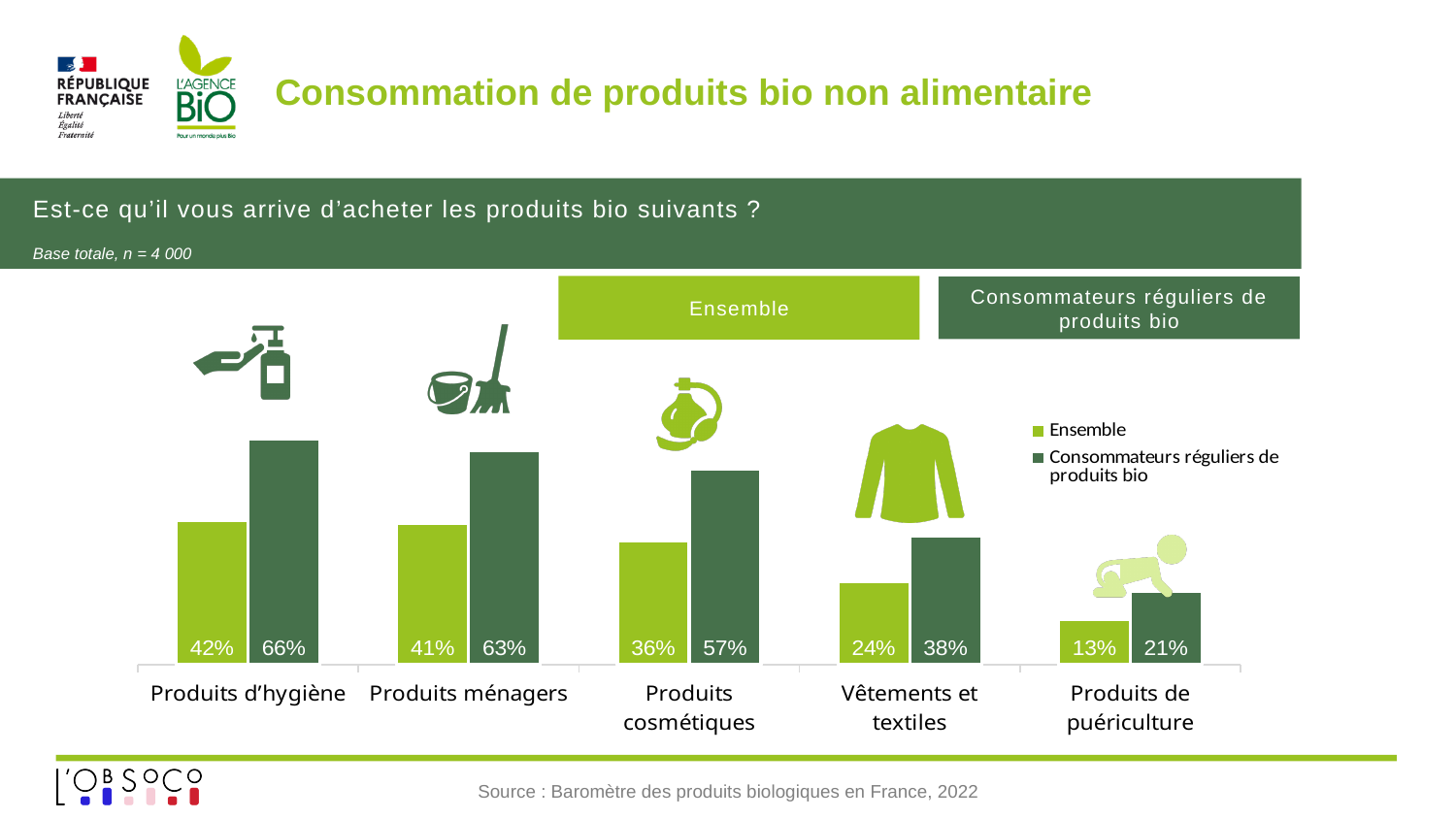
What is the source cited at the bottom of the slide? Baromètre des produits biologiques en France, 2022 What kind of chart is shown on the slide? Bar chart Which category has the highest value among Consommateurs réguliers de produits bio? Produits d'hygiène What is the difference between the Consommateurs réguliers de produits bio value and the Ensemble value for Produits ménagers? 22 points Which category has the lowest value in the Ensemble series? Produits de puériculture What is the value for Produits d'hygiène in the Ensemble series? 42% What is the value for Produits de puériculture among Consommateurs réguliers de produits bio? 21% How many product categories are shown on the chart? 5 Which is larger: the Ensemble value for Vêtements et textiles or the Ensemble value for Produits cosmétiques? Produits cosmétiques Do the Ensemble values rise or fall from left to right across the categories? Fall How many series does the legend list? 2 What is the value for Produits cosmétiques in the Ensemble series? 36%